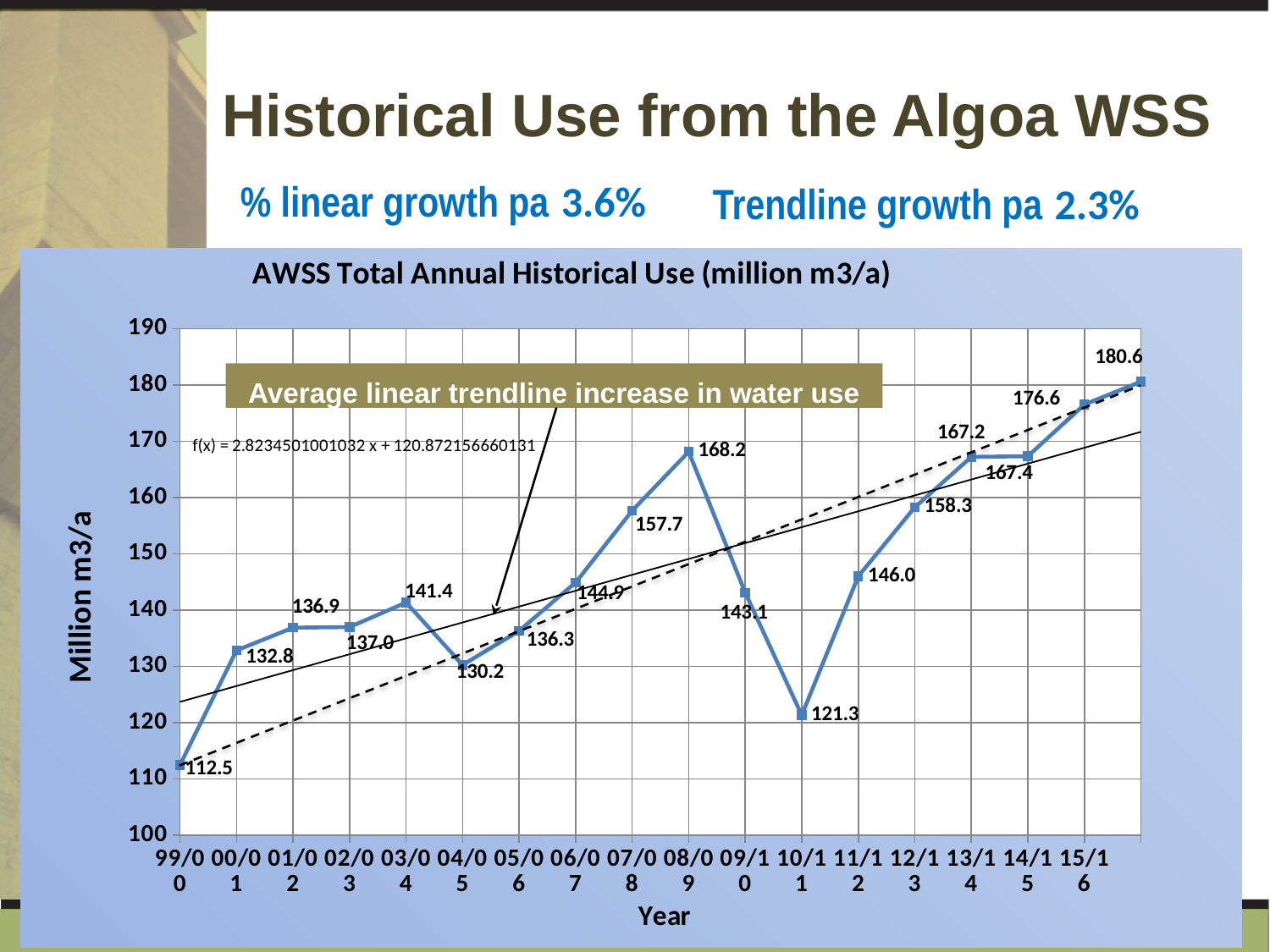
What is the difference between the values for 15/16 and 14/15 in the AWSS Total Annual Historical Use chart? 9.2 What is the value for 12/13 in the AWSS Total Annual Historical Use chart? 158.3 What is the value for 10/11 in the AWSS Total Annual Historical Use chart? 121.3 What is the value for 04/05 in the AWSS Total Annual Historical Use chart? 130.2 What is the highest value plotted in the AWSS Total Annual Historical Use chart? 180.6 Overall, do the values in the AWSS Total Annual Historical Use chart rise or fall from 99/00 to the right end of the x axis? Rise What is the value for 08/09 in the AWSS Total Annual Historical Use chart? 168.2 What is the y-axis title of the AWSS Total Annual Historical Use chart? Million m3/a What kind of chart is the AWSS Total Annual Historical Use chart? Line chart Which year has the lowest value in the AWSS Total Annual Historical Use chart? 99/00 Which is larger in the AWSS Total Annual Historical Use chart, the value for 09/10 or the value for 11/12? 11/12 What is the difference between the values for 08/09 and 07/08 in the AWSS Total Annual Historical Use chart? 10.5